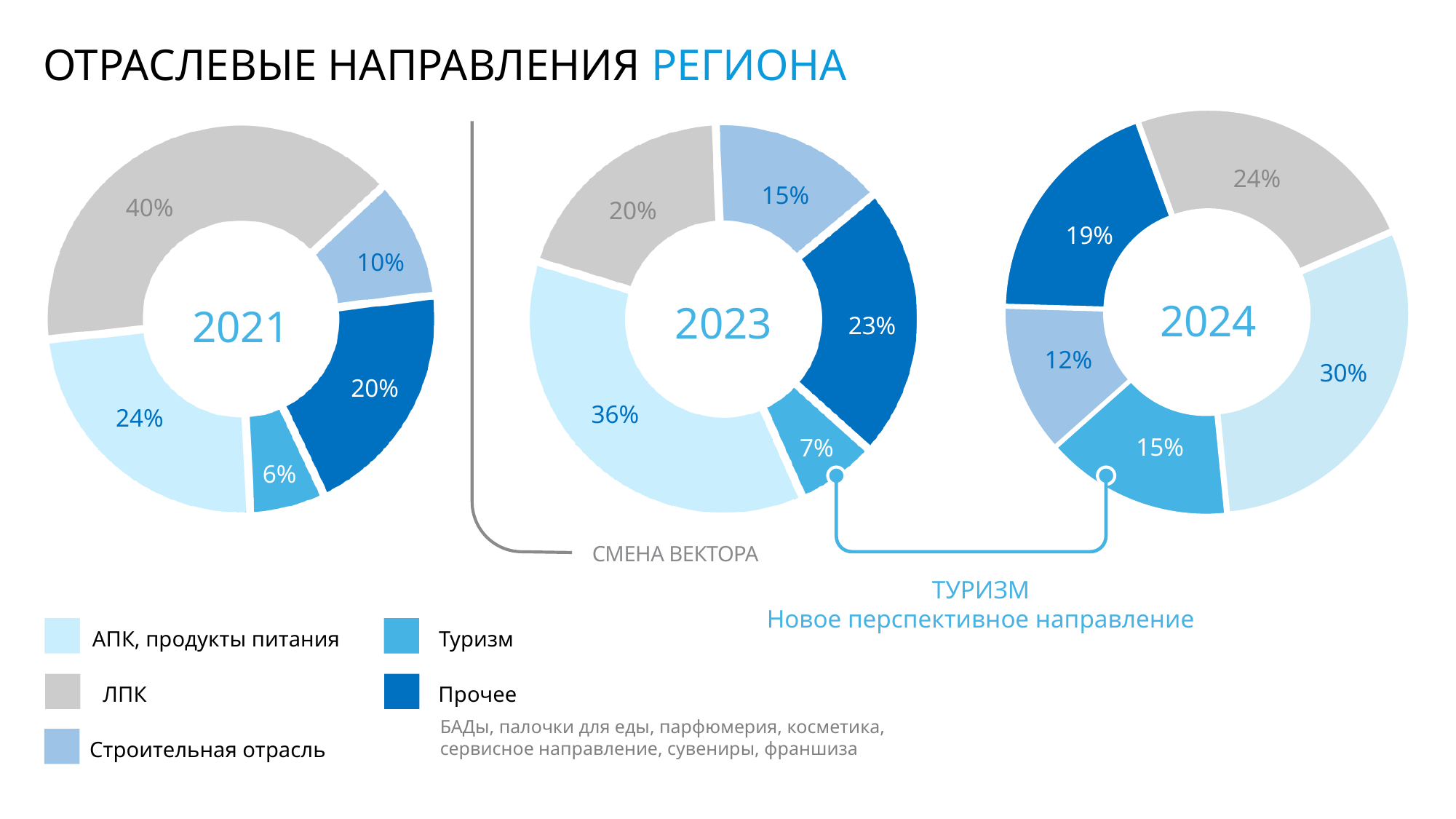
In the 2024 chart, what share does Туризм have? 15% In the 2024 chart, which category has the largest share? АПК, продукты питания What is the difference between the Туризм share in the 2024 chart and the Туризм share in the 2023 chart? 8% How many categories does the legend list? 5 In the 2021 chart, what share does ЛПК have? 40% What type of chart is used for the 2021, 2023 and 2024 data? Donut (pie) chart In the 2023 chart, what share does АПК, продукты питания have? 36% In the 2024 chart, what share does Прочее have? 19% In the 2023 chart, which is larger: the share of Прочее or the share of ЛПК? Прочее In the 2023 chart, which category has the smallest share? Туризм How many charts are shown on the slide? 3 In the 2021 chart, which category has the largest share? ЛПК